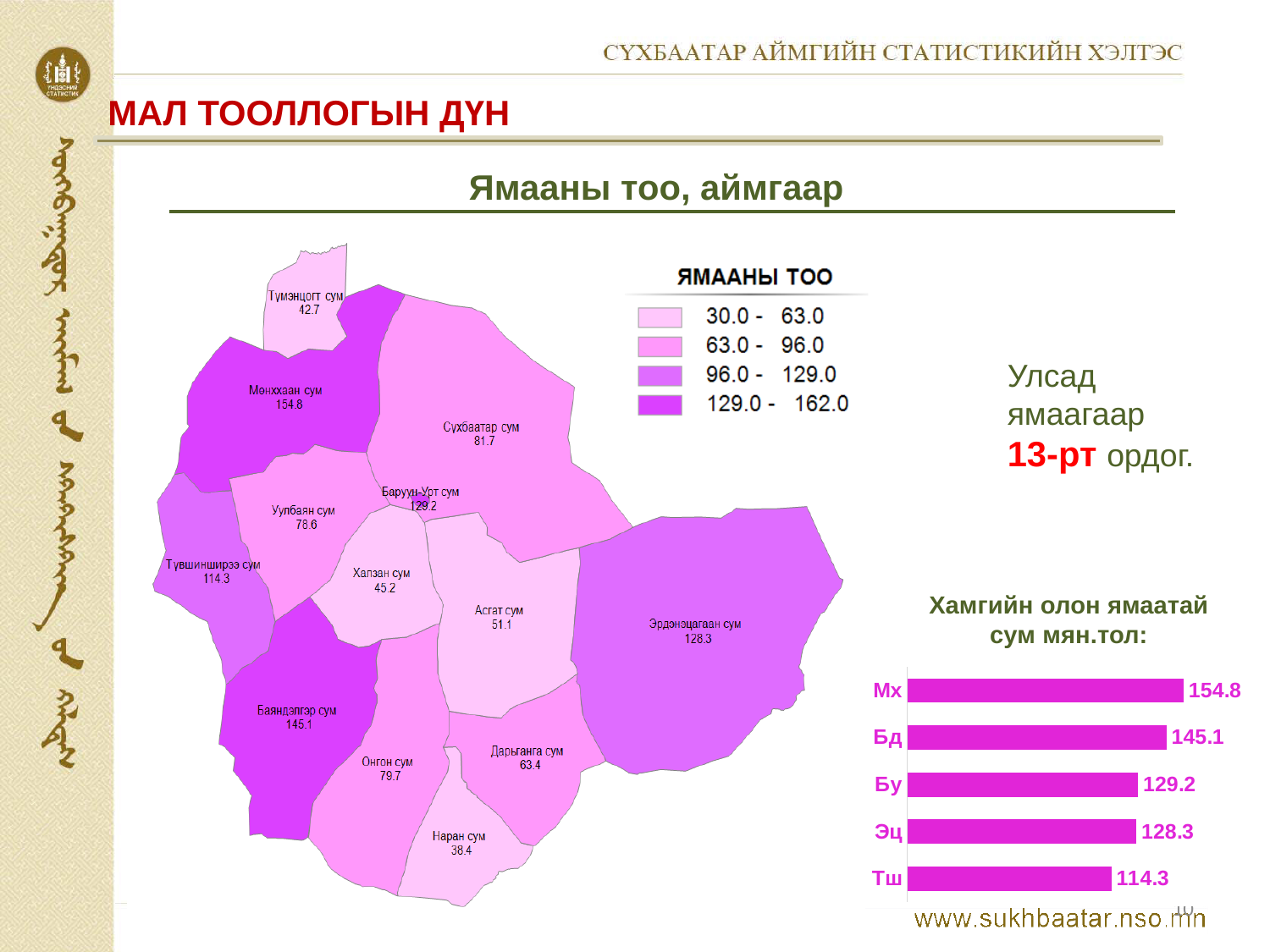
What kind of chart is 'Хамгийн олон ямаатай сум мян.тол:'? bar chart In the bar chart 'Хамгийн олон ямаатай сум мян.тол:', what is the difference between the values for Мх and Бд? 9.7 In the bar chart 'Хамгийн олон ямаатай сум мян.тол:', what is the difference between the values for Бу and Эц? 0.9 On the map 'Ямааны тоо, аймгаар', what value is shown for Эрдэнэцагаан сум? 128.3 On the map 'Ямааны тоо, аймгаар', what value is shown for Наран сум? 38.4 In the bar chart 'Хамгийн олон ямаатай сум мян.тол:', which is larger, the value for Бд or the value for Бу? Бд In the bar chart 'Хамгийн олон ямаатай сум мян.тол:', what is the value for Тш? 114.3 In the bar chart 'Хамгийн олон ямаатай сум мян.тол:', do the values rise or fall going from the top bar to the bottom bar? fall In the bar chart 'Хамгийн олон ямаатай сум мян.тол:', what is the value for Мх? 154.8 In the bar chart 'Хамгийн олон ямаатай сум мян.тол:', which category has the lowest value? Тш How many categories are shown in the bar chart 'Хамгийн олон ямаатай сум мян.тол:'? 5 In the bar chart 'Хамгийн олон ямаатай сум мян.тол:', which category has the highest value? Мх